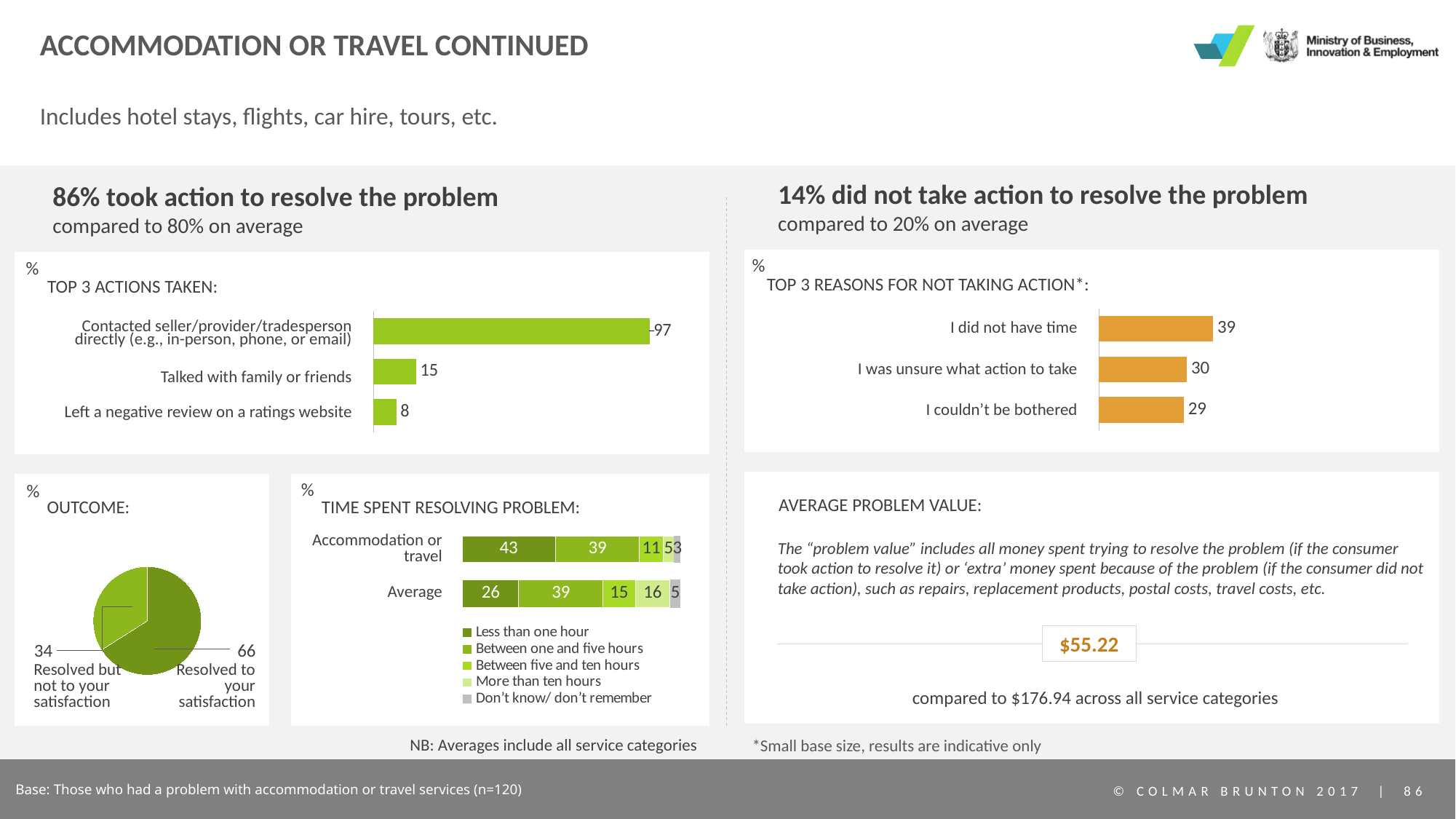
In the 'TOP 3 ACTIONS TAKEN' chart, what is the difference between 'Talked with family or friends' and 'Left a negative review on a ratings website'? 7 In the 'TOP 3 REASONS FOR NOT TAKING ACTION' chart, what is the value for 'I was unsure what action to take'? 30 In the 'TOP 3 ACTIONS TAKEN' chart, what is the value for 'Contacted seller/provider/tradesperson directly'? 97 In the 'OUTCOME' pie chart, which is larger: 'Resolved to your satisfaction' or 'Resolved but not to your satisfaction'? Resolved to your satisfaction In the 'TIME SPENT RESOLVING PROBLEM' chart, what is the 'Less than one hour' value for 'Accommodation or travel'? 43 In the 'TOP 3 REASONS FOR NOT TAKING ACTION' chart, how many reasons are shown? 3 In the 'TOP 3 ACTIONS TAKEN' chart, which action has the lowest value? Left a negative review on a ratings website What kind of chart is the 'OUTCOME' chart? Pie chart In the 'TIME SPENT RESOLVING PROBLEM' chart, what is the difference between the 'Less than one hour' values for 'Accommodation or travel' and 'Average'? 17 In the 'OUTCOME' pie chart, what share is 'Resolved to your satisfaction'? 66 How many series does the legend of the 'TIME SPENT RESOLVING PROBLEM' chart list? 5 In the 'TOP 3 REASONS FOR NOT TAKING ACTION' chart, which reason has the highest value? I did not have time